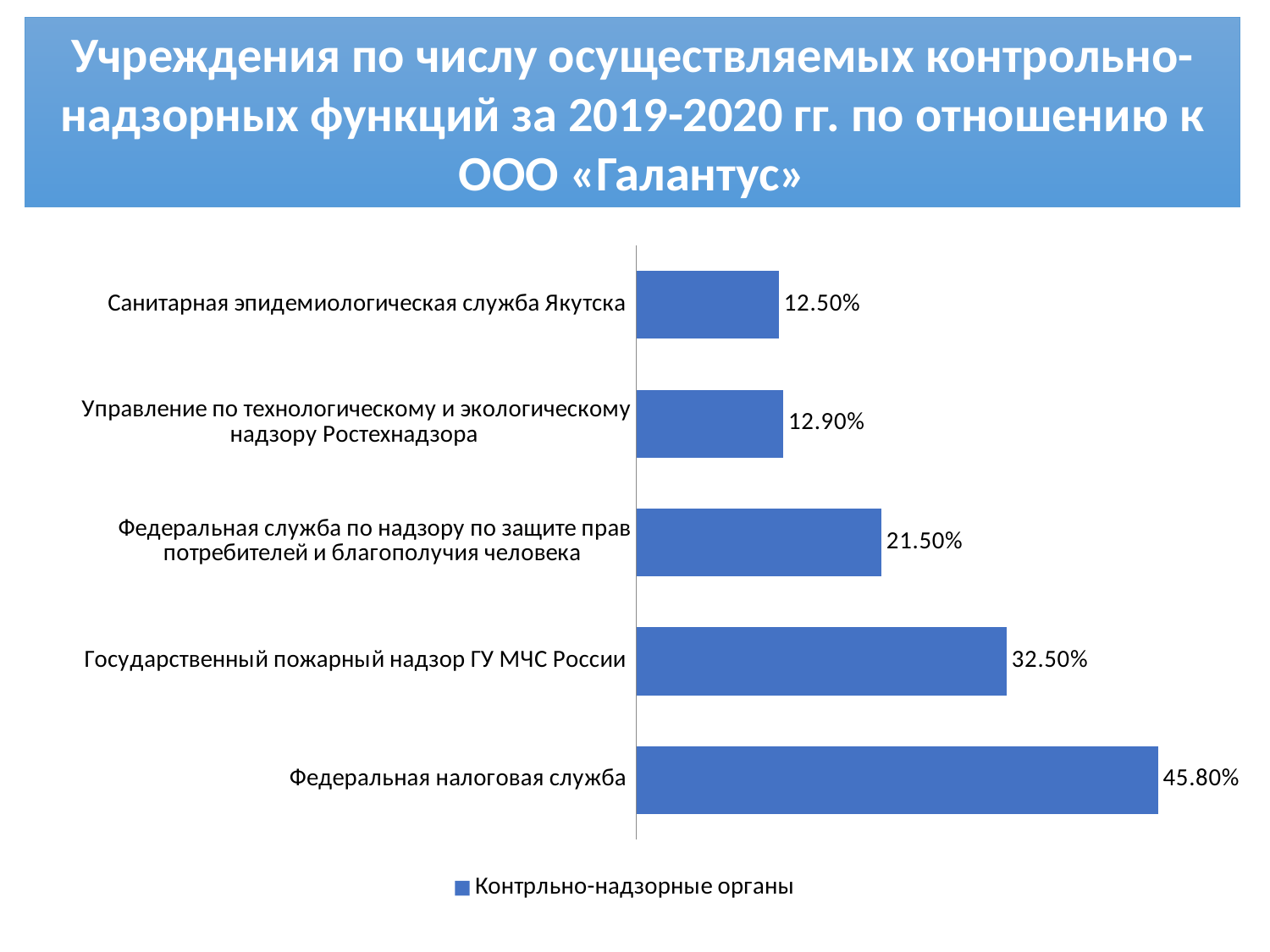
What is the difference between the values for Федеральная налоговая служба and Государственный пожарный надзор ГУ МЧС России? 13.30% What kind of chart is shown on the slide? Bar chart What is the value for Государственный пожарный надзор ГУ МЧС России? 32.50% What is the legend entry of the chart? Контрльно-надзорные органы How many categories are shown in the chart? 5 Which category has the highest value? Федеральная налоговая служба How many series does the legend list? 1 What is the value for Санитарная эпидемиологическая служба Якутска? 12.50% What is the value for Федеральная налоговая служба? 45.80% Which category has the lowest value? Санитарная эпидемиологическая служба Якутска Which is larger: the value for Управление по технологическому и экологическому надзору Ростехнадзора or the value for Федеральная служба по надзору по защите прав потребителей и благополучия человека? Федеральная служба по надзору по защите прав потребителей и благополучия человека What is the value for Федеральная служба по надзору по защите прав потребителей и благополучия человека? 21.50%